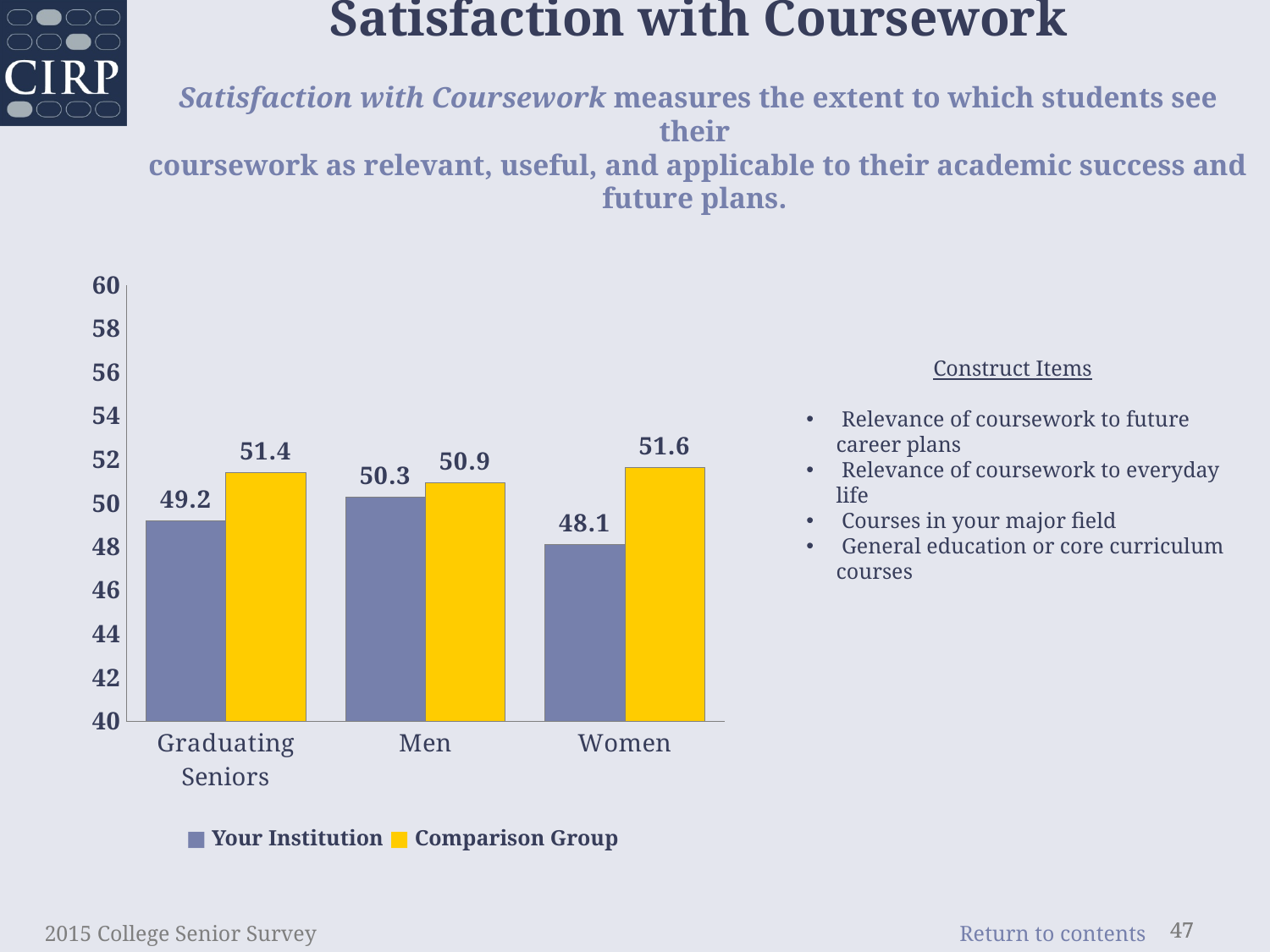
What is the Your Institution value for Men? 50.3 What is the difference between the Comparison Group and Your Institution values for Men? 0.6 What is the Your Institution value for Graduating Seniors? 49.2 How many categories are shown on the x axis? 3 Which is larger for Graduating Seniors: Your Institution or Comparison Group? Comparison Group How many series does the legend list? 2 What is the difference between the Comparison Group and Your Institution values for Women? 3.5 What is the Comparison Group value for Women? 51.6 Which category has the lowest Your Institution value? Women Which category has the highest Comparison Group value? Women What kind of chart is shown on the slide? Bar chart What colour represents the Comparison Group series? Yellow